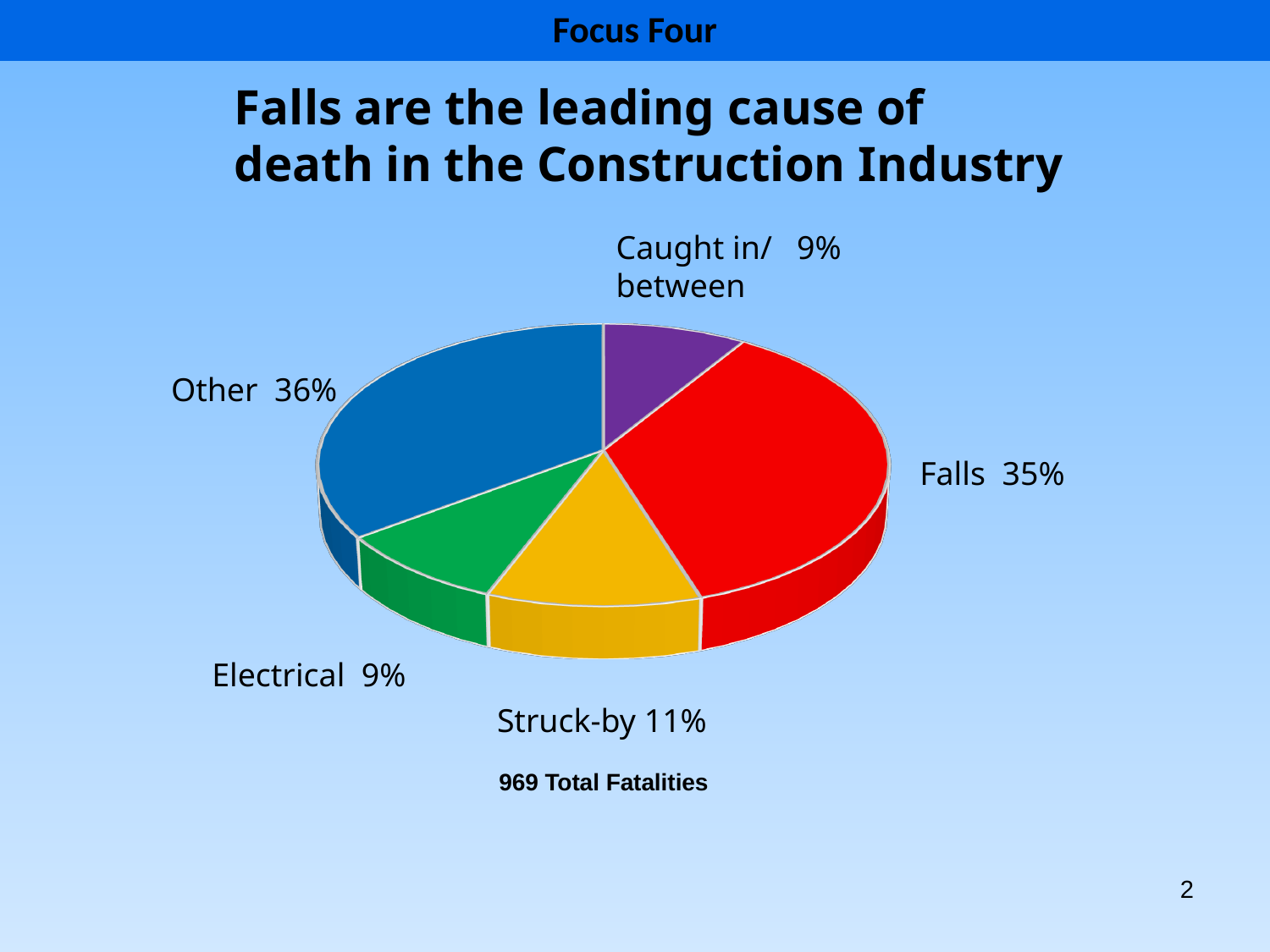
What colour is the Falls slice of the pie chart? red What is the difference in percentage points between the Other share and the Electrical share? 27 Which is larger, the share for Falls or the share for Struck-by? Falls What percentage of fatalities is attributed to Falls? 35% What percentage of fatalities is attributed to Struck-by? 11% What total number of fatalities is stated below the pie chart? 969 Total Fatalities How many slices does the pie chart have? 5 What percentage of fatalities is attributed to Electrical? 9% What kind of chart is shown on the slide? pie chart What percentage of fatalities is attributed to Caught in/between? 9% What percentage of fatalities is attributed to Other? 36% What is the difference in percentage points between the Falls share and the Struck-by share? 24